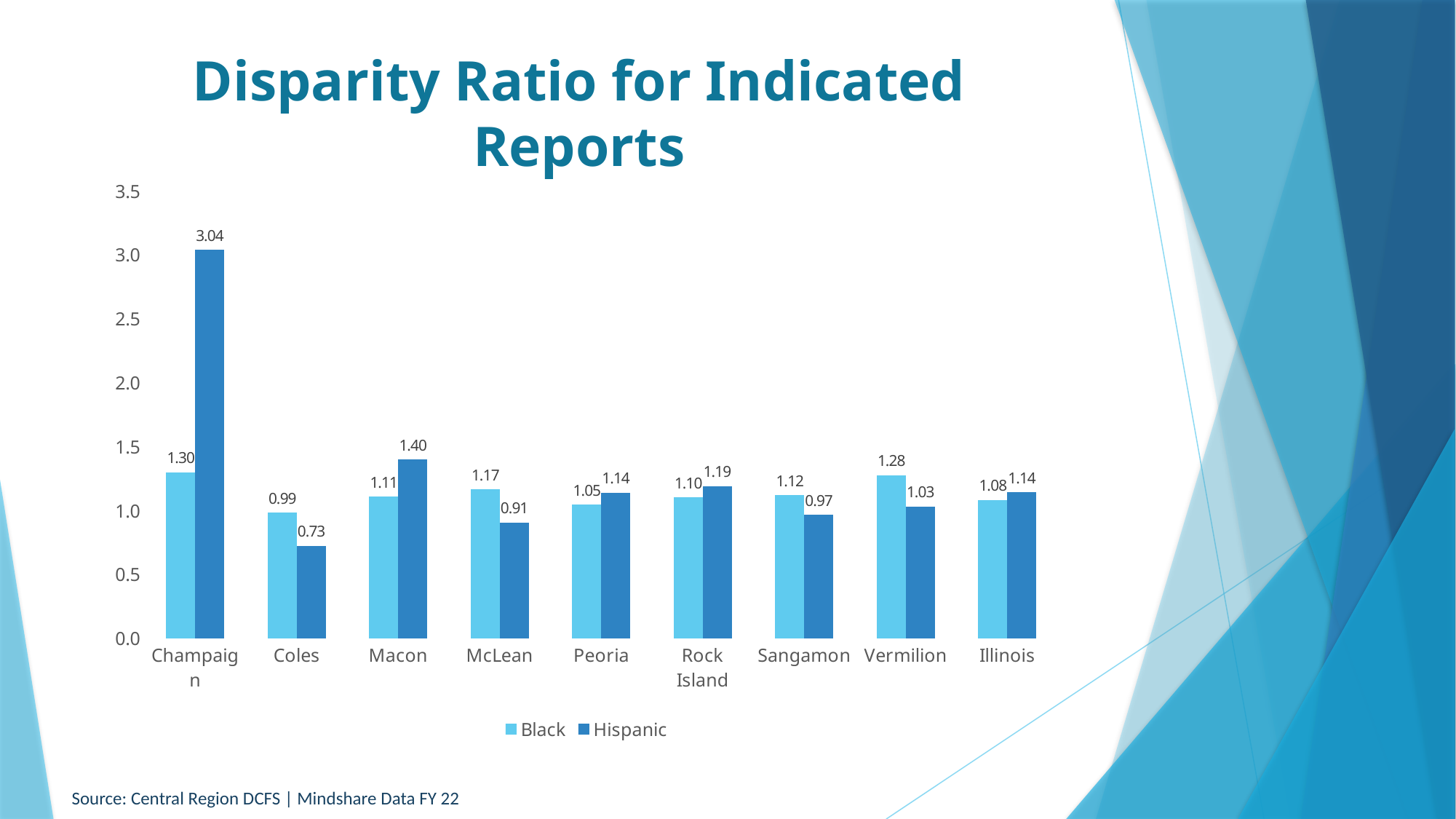
What is the Hispanic disparity ratio for Champaign? 3.04 What kind of chart is shown on the slide? Bar chart How many categories are shown on the x axis? 9 How many series does the legend list? 2 Which category has the lowest Black disparity ratio? Coles What is the difference between the Hispanic and Black disparity ratios for Champaign? 1.74 Is the Hispanic value for Champaign greater or less than 3.0? greater What is the Hispanic disparity ratio for Coles? 0.73 Which category has the highest Hispanic disparity ratio? Champaign Which is larger for McLean, the Black or the Hispanic disparity ratio? Black What is the title of the chart? Disparity Ratio for Indicated Reports What is the Black disparity ratio for Vermilion? 1.28